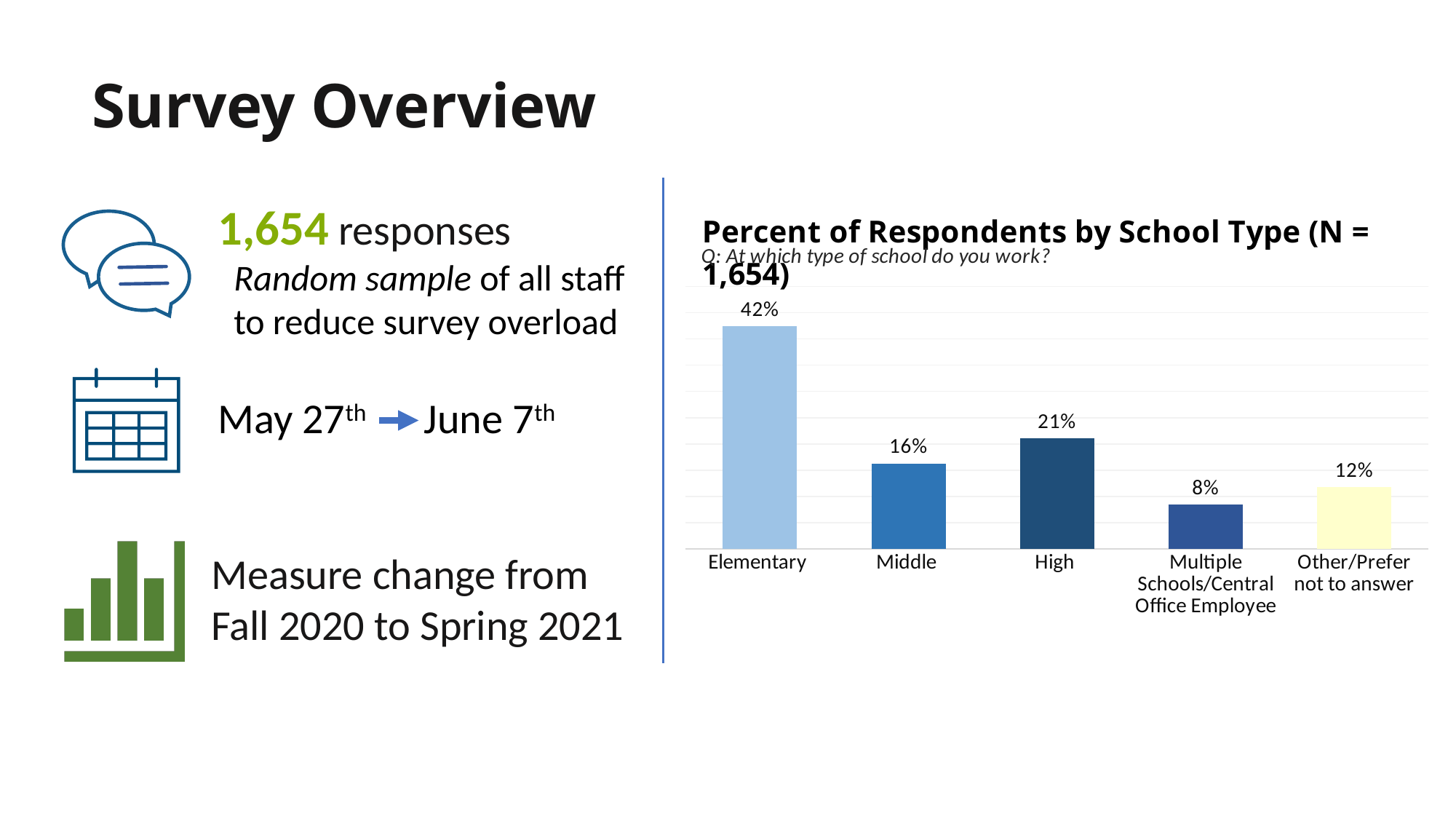
What percent of respondents work at an Elementary school? 42% How many categories are shown on the chart? 5 What kind of chart is shown on the slide? Bar chart What percent of respondents chose Other/Prefer not to answer? 12% What percent of respondents are Multiple Schools/Central Office Employees? 8% Which category has the lowest percent of respondents? Multiple Schools/Central Office Employee What is the difference in percentage points between Elementary and High school respondents? 21% What is the title of the chart? Percent of Respondents by School Type (N = 1,654) What survey question is shown beneath the chart title? Q: At which type of school do you work? What percent of respondents work at a Middle school? 16% Which school type has the highest percent of respondents? Elementary Which has a larger share of respondents, Middle or High? High